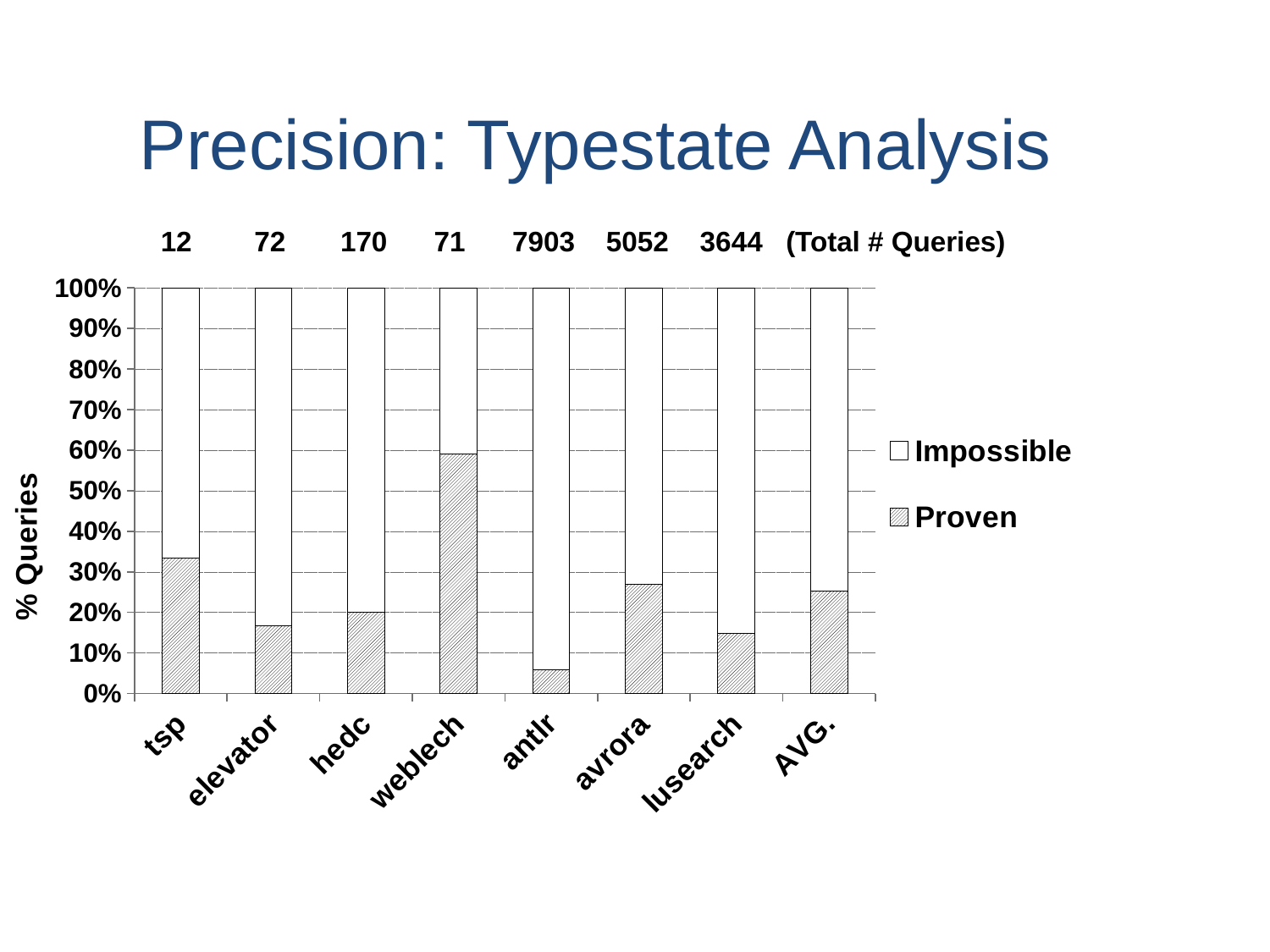
Is the Proven share for tsp greater or less than 30%? greater How many benchmark categories are shown along the x axis? 8 Which category has the highest Proven share? weblech Which has a larger Proven share, tsp or elevator? tsp Which category has the lowest Proven share? antlr Is the Proven share for antlr greater or less than 10%? less What is the title of the slide? Precision: Typestate Analysis What is the total number of queries printed above the antlr bar? 7903 What are the two series named in the legend? Impossible and Proven Is the Proven share for weblech greater or less than 50%? greater What type of chart is shown on the slide? stacked bar chart How many series does the legend list? 2